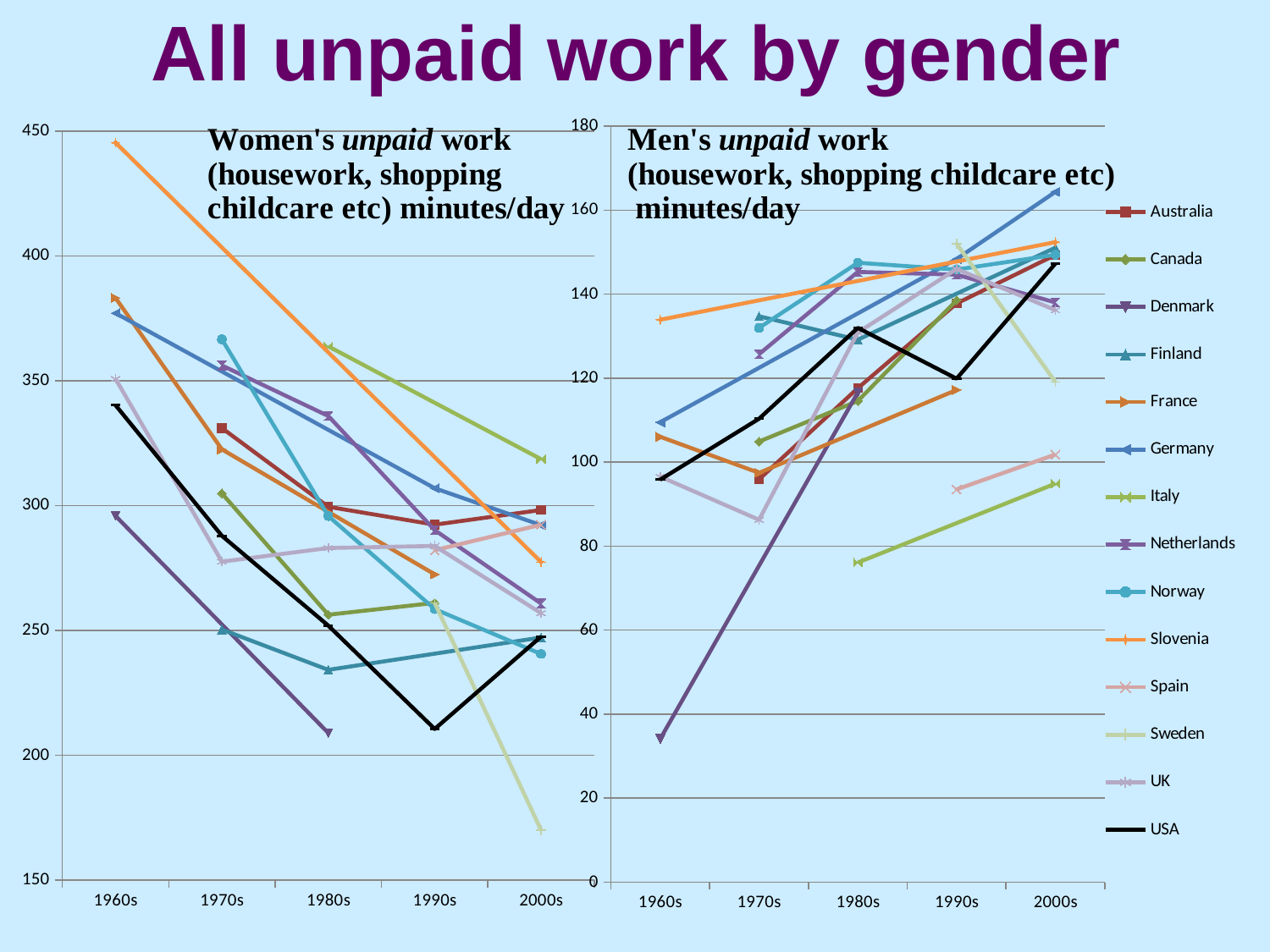
How many decades are shown on the x axis of the Men's unpaid work chart? 5 In the Men's unpaid work chart, does the line for Germany rise or fall from the 1960s to the 2000s? rise In the Women's unpaid work chart, which country has the highest value in the 1960s? Slovenia In the Men's unpaid work chart, which is larger in the 2000s, Germany or Italy? Germany In the Women's unpaid work chart, which country has the lowest value in the 2000s? Sweden What kind of chart is the Women's unpaid work chart on the left? line chart In the Women's unpaid work chart, does the line for Slovenia rise or fall from the 1960s to the 2000s? fall How many countries does the legend list? 14 In the Women's unpaid work chart, is the value for Sweden in the 2000s greater or less than 200? less In the Men's unpaid work chart, which country has the lowest value in the 1960s? Denmark In the Men's unpaid work chart, is the value for Italy in the 1980s greater or less than 100? less In the Women's unpaid work chart, is the value for Slovenia in the 1960s greater or less than 400? greater